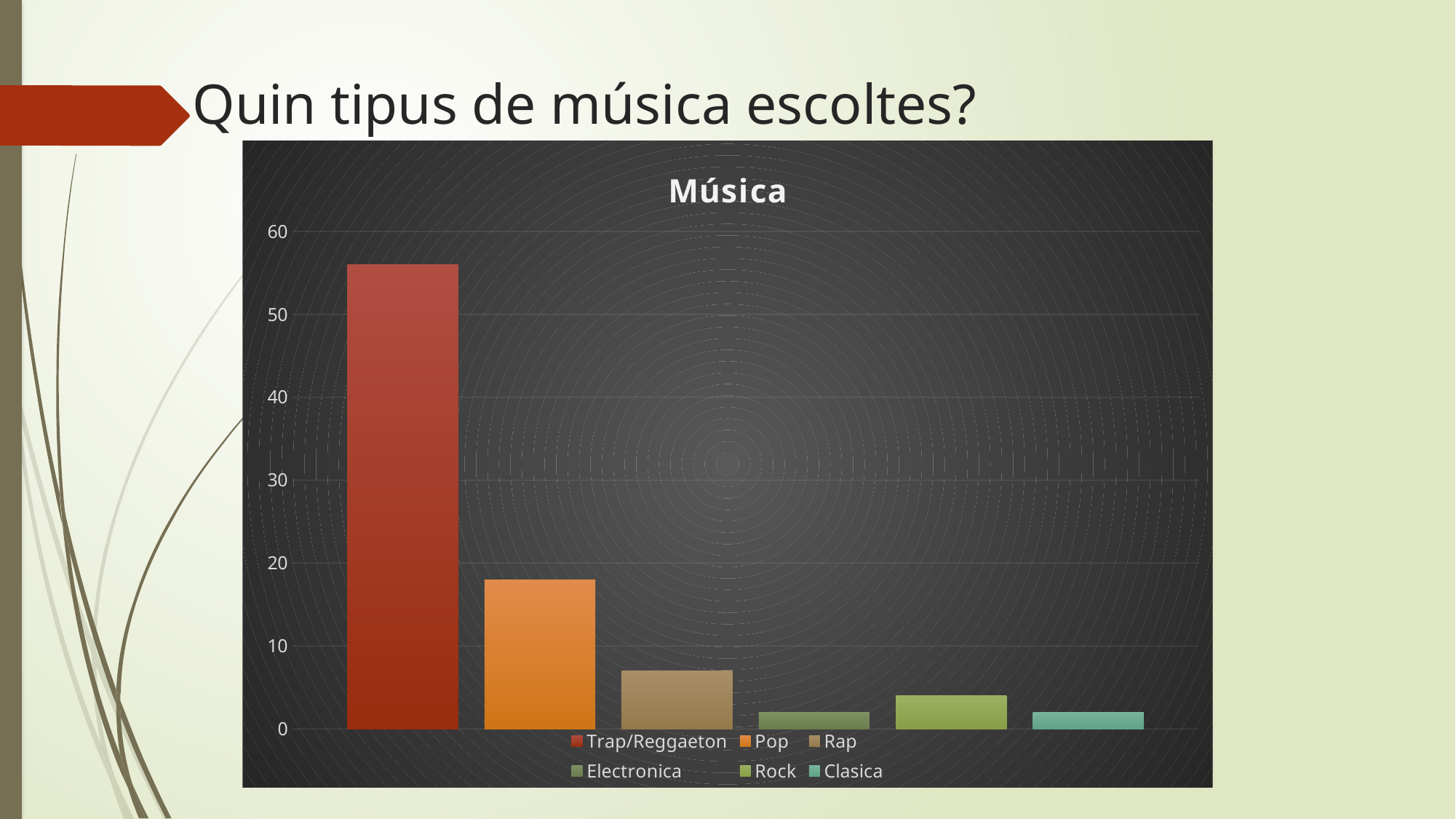
Which legend entry is shown in red? Trap/Reggaeton Which category has the highest value in the chart? Trap/Reggaeton Is the value for Pop greater or less than 20? less Which is larger, the value for Rock or the value for Electronica? Rock What is the title of the chart? Música Is the value for Trap/Reggaeton greater or less than 60? less How many bars are plotted in the chart? 6 Is the value for Trap/Reggaeton greater or less than 50? greater Which is larger, the value for Pop or the value for Rap? Pop What kind of chart is shown on the slide? bar chart How many entries does the legend list? 6